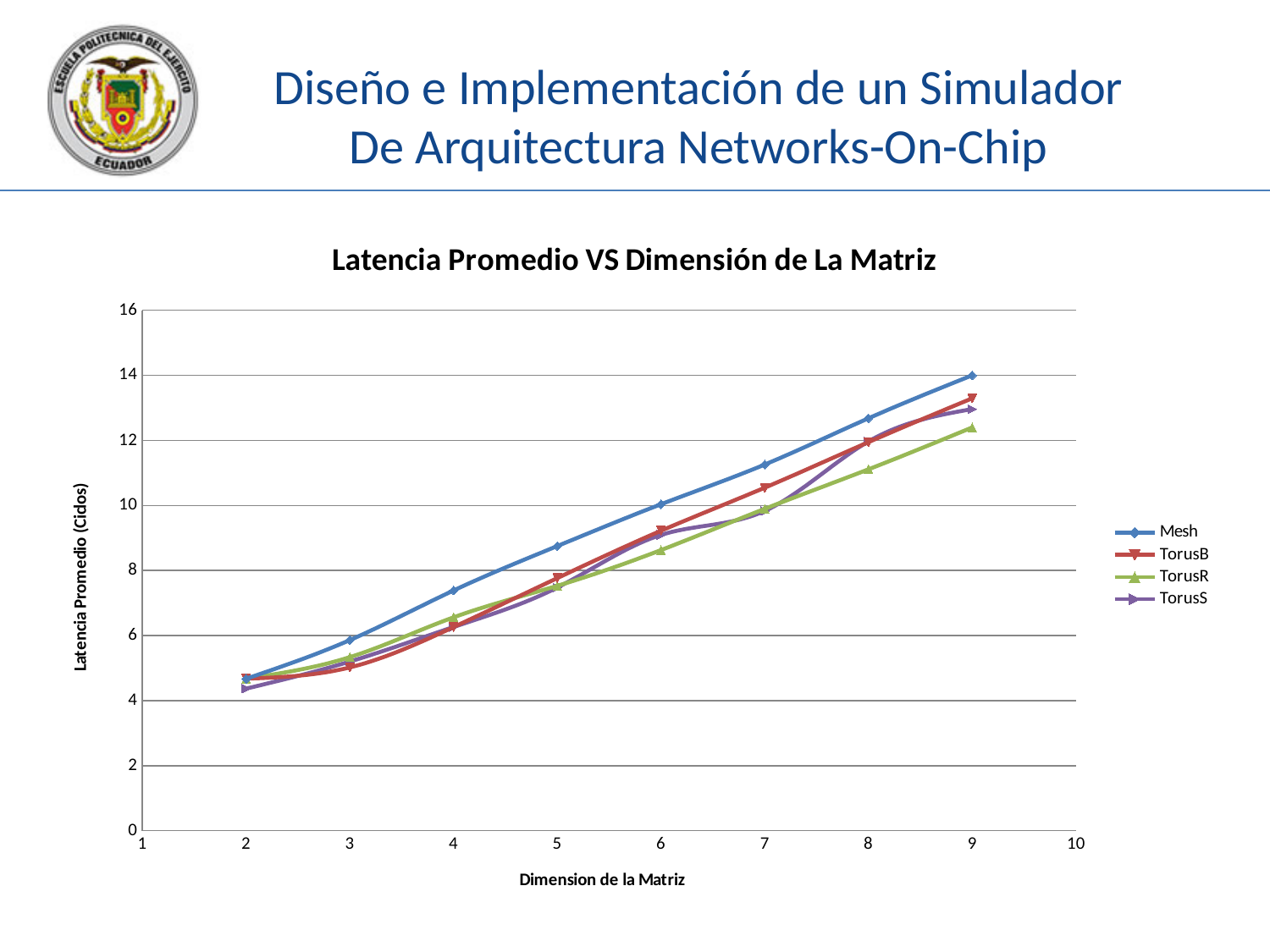
How many series does the legend list? 4 What is the label of the y axis? Latencia Promedio (Ciclos) Is the value for Mesh at dimension 8 greater or less than 12? greater What kind of chart is shown on the slide? line chart Which series has the highest latency at dimension 9? Mesh Is the value for Mesh at dimension 4 greater or less than 8? less Which series has the highest latency at dimension 5? Mesh Which series has the lowest latency at dimension 9? TorusR How many data points are plotted for the Mesh series? 8 Does the Mesh series rise or fall as the Dimension de la Matriz increases? rise At dimension 6, which is larger, the value for Mesh or the value for TorusR? Mesh What is the title of the chart? Latencia Promedio VS Dimensión de La Matriz